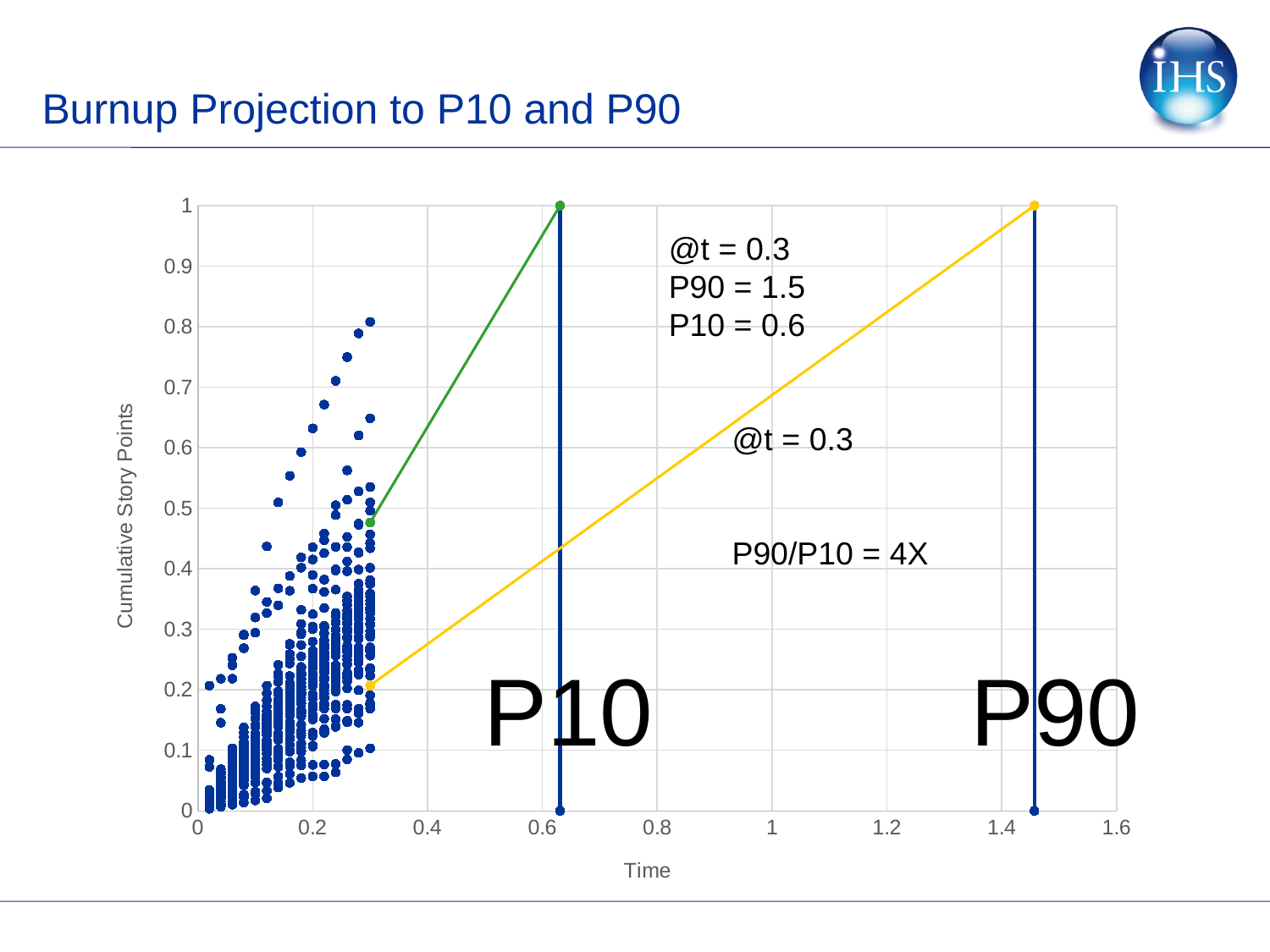
What is the label of the y axis? Cumulative Story Points According to the annotation at t = 0.3, what is the P10 value? 0.6 What kind of chart is shown on the slide? scatter chart Is the time at which the P90 vertical line is drawn greater or less than 1.4? greater What ratio of P90 to P10 is stated on the chart? 4X What is the label of the x axis? Time Is the time at which the P10 vertical line is drawn greater or less than 0.8? less Which projection line reaches 1 cumulative story point at a later time, the green line or the yellow line? the yellow line Is the highest blue scatter point greater or less than 0.7 cumulative story points? greater According to the annotation at t = 0.3, what is the P90 value? 1.5 Do the blue scatter points generally rise or fall as time increases? rise